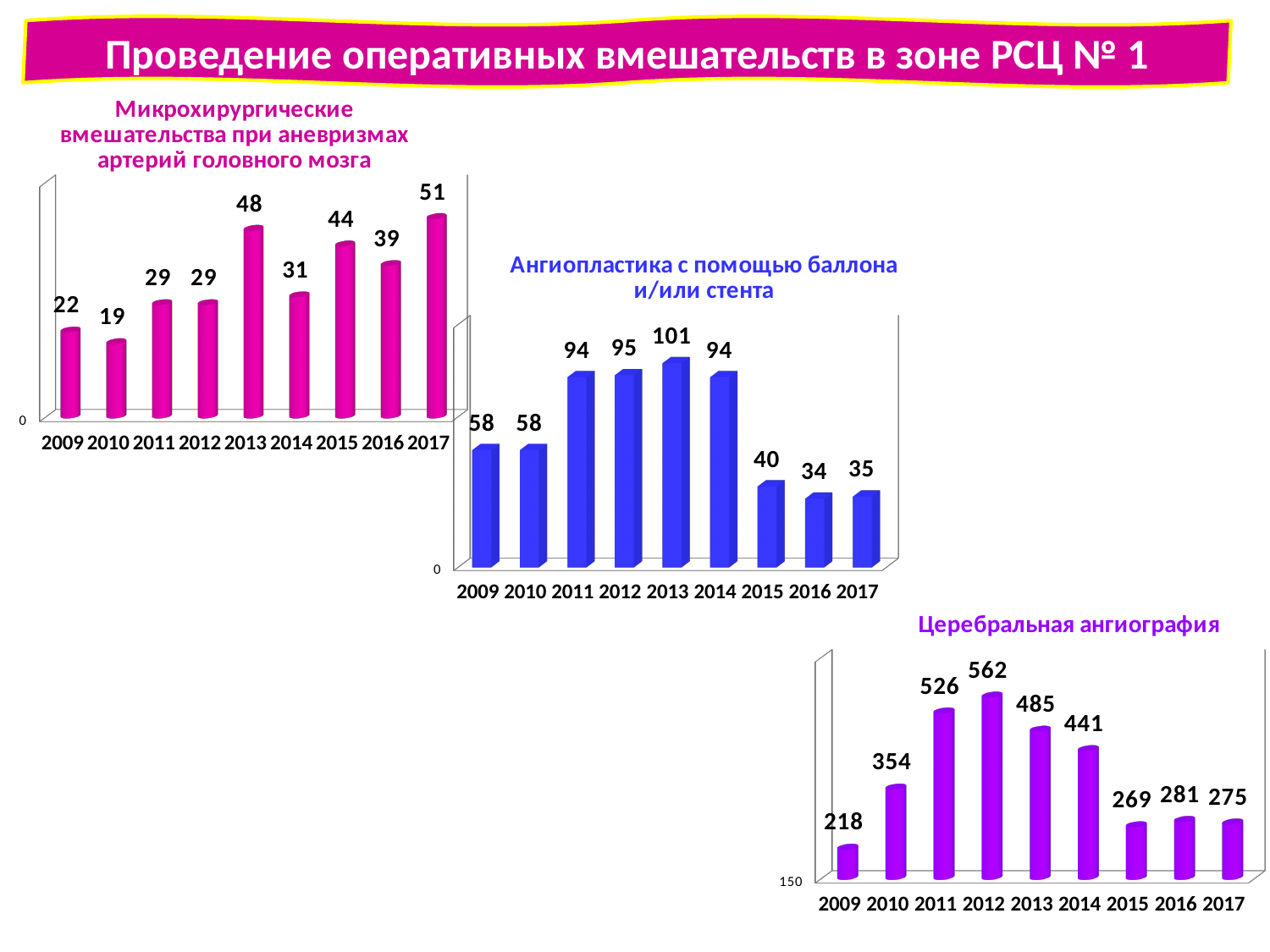
In the chart titled 'Церебральная ангиография', what is the difference between the values for 2012 and 2009? 344 In the chart titled 'Ангиопластика с помощью баллона и/или стента', what is the value for 2015? 40 In the chart titled 'Церебральная ангиография', what is the value for 2011? 526 In the chart titled 'Ангиопластика с помощью баллона и/или стента', which year has the highest value? 2013 In the chart titled 'Ангиопластика с помощью баллона и/или стента', how many years are shown on the x axis? 9 In the chart titled 'Церебральная ангиография', which year has the highest value? 2012 In the chart titled 'Ангиопластика с помощью баллона и/или стента', which year has the lowest value? 2016 In the chart titled 'Церебральная ангиография', which is larger, the value for 2014 or the value for 2016? 2014 In the chart titled 'Микрохирургические вмешательства при аневризмах артерий головного мозга', which year has the lowest value? 2010 In the chart titled 'Микрохирургические вмешательства при аневризмах артерий головного мозга', what is the difference between the values for 2017 and 2009? 29 In the chart titled 'Микрохирургические вмешательства при аневризмах артерий головного мозга', what is the value for 2013? 48 What type of chart is the chart titled 'Церебральная ангиография'? Bar chart